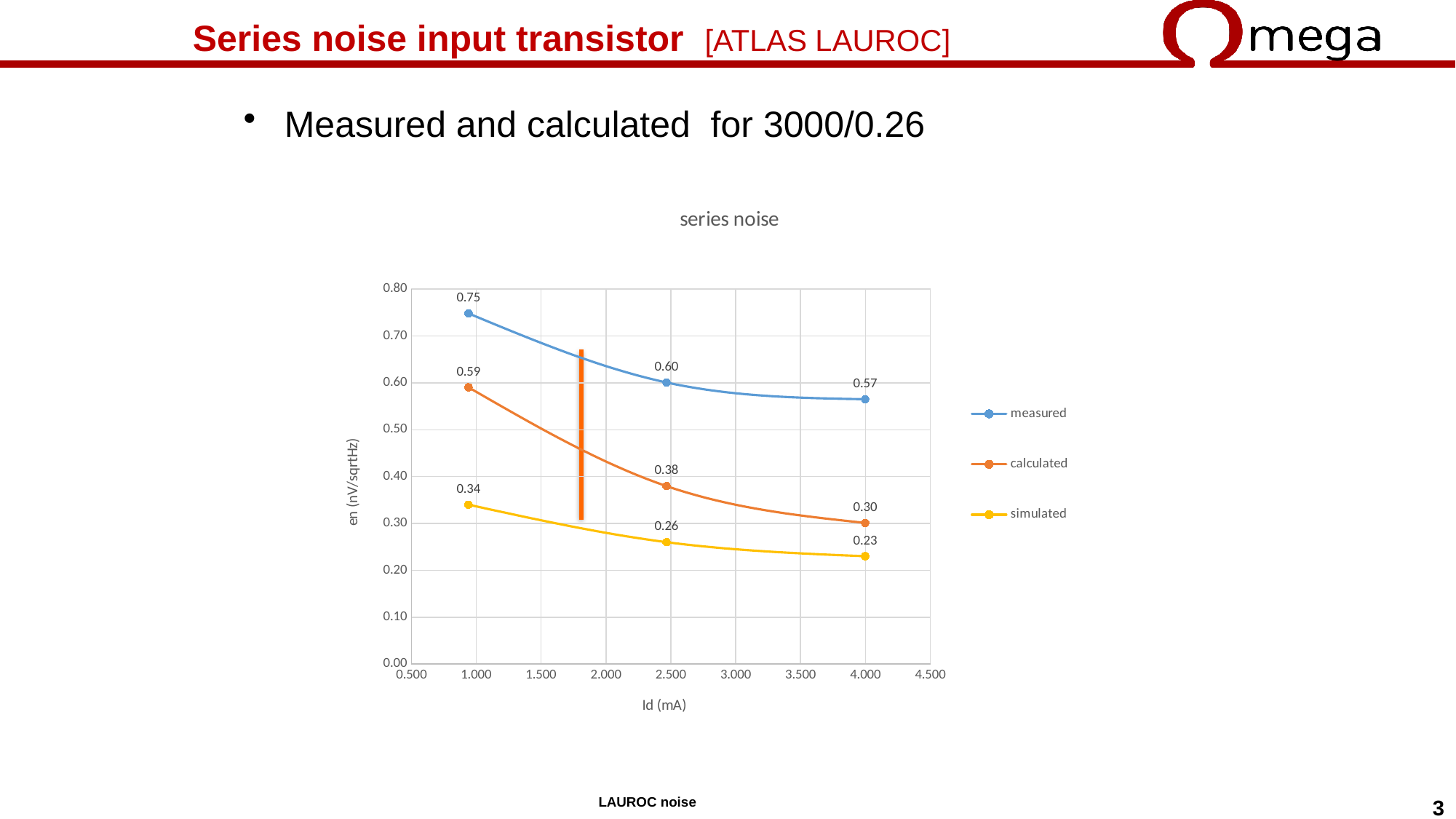
What kind of chart is shown on the slide? line chart Which series has the lowest value at the rightmost data point? simulated What is the difference between the measured and calculated values at the leftmost data point? 0.16 What is the value of the middle point of the simulated series? 0.26 Do the values of the calculated series rise or fall as Id increases? fall What is the value of the leftmost point of the measured series? 0.75 What is the value of the rightmost point of the calculated series? 0.30 Which is larger at the middle data point: the measured value or the simulated value? measured Which series has the highest value at the leftmost data point? measured What is the title of the chart? series noise How many series does the chart legend list? 3 How many data points are plotted for the measured series? 3